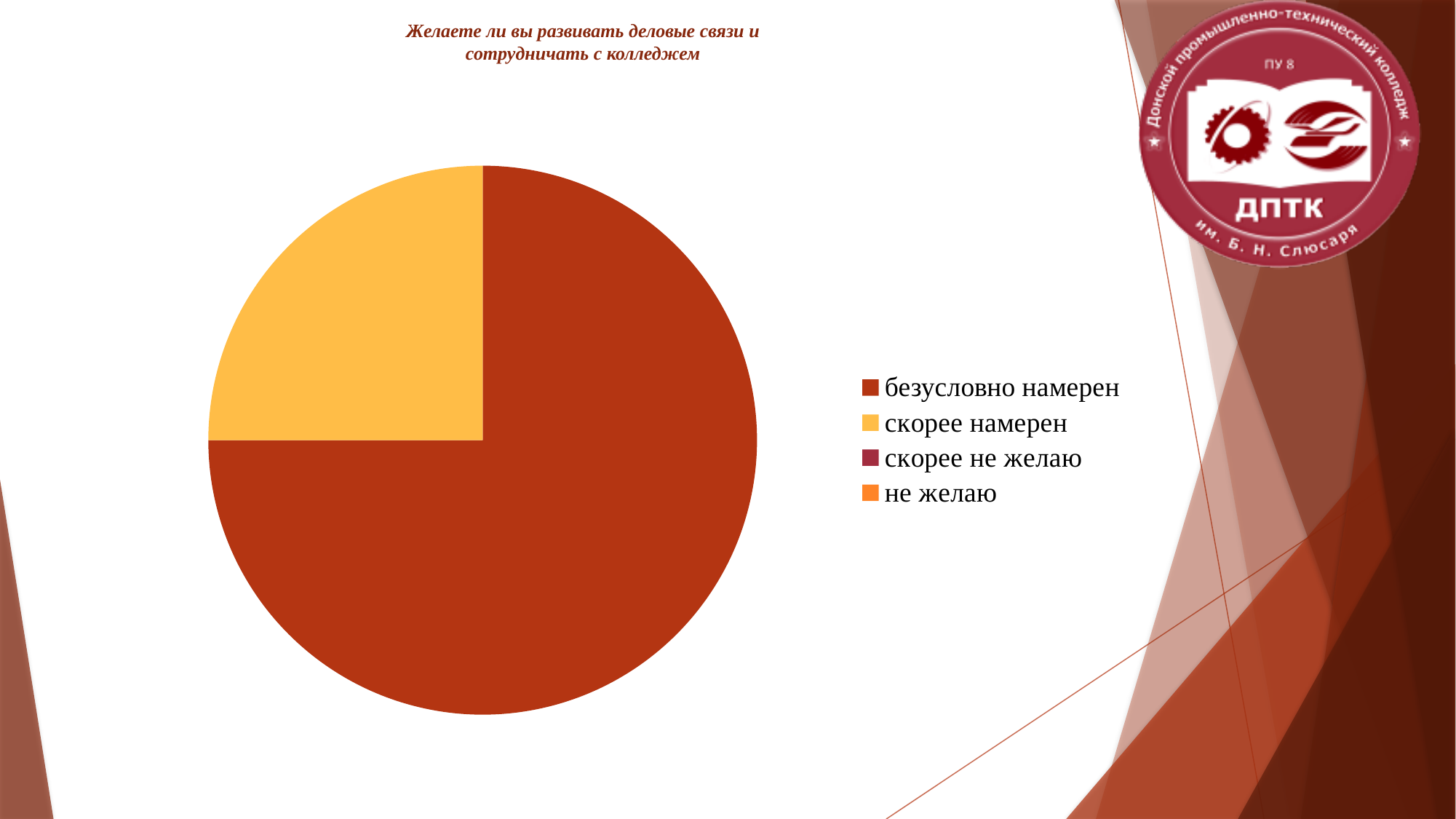
How many slices are visible in the pie chart? 2 Which legend entry is shown in yellow? скорее намерен Which of the visible slices is the smallest? скорее намерен How many entries does the legend list? 4 What kind of chart is shown on the slide? pie chart Which category has the largest slice of the pie? безусловно намерен Which slice is larger: безусловно намерен or скорее намерен? безусловно намерен What is the title of the chart? Желаете ли вы развивать деловые связи и сотрудничать с колледжем